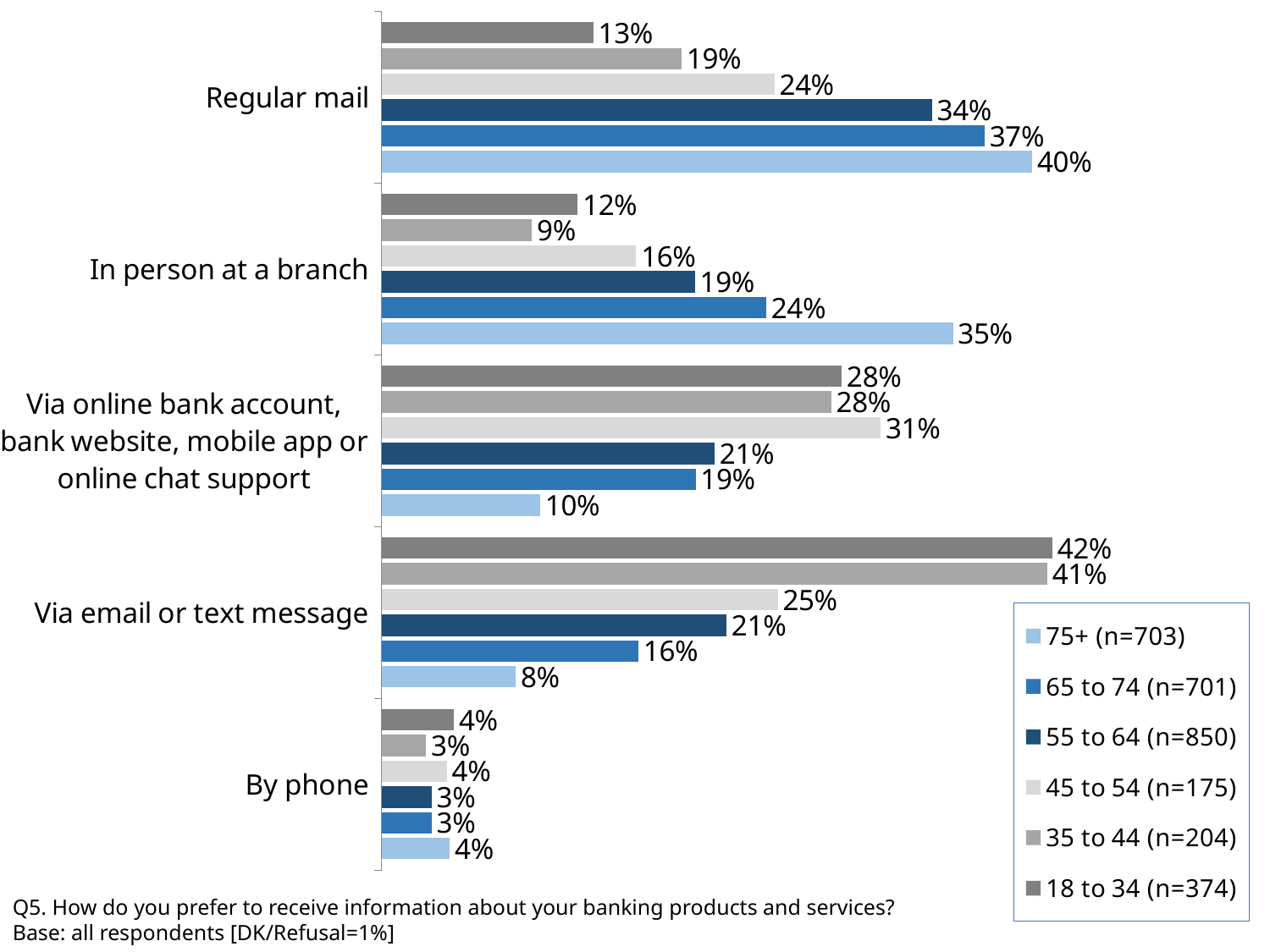
How many series does the legend list? 6 What is the difference between the 75+ (n=703) and 18 to 34 (n=374) values for Regular mail? 27% Which age group has the lowest value for Via email or text message? 75+ (n=703) What is the value for the 18 to 34 (n=374) group for Via email or text message? 42% For Via online bank account, bank website, mobile app or online chat support, which is larger: the value for 45 to 54 (n=175) or the value for 55 to 64 (n=850)? 45 to 54 (n=175) What is the value for the 75+ (n=703) group for Regular mail? 40% How many categories are shown on the chart? 5 Which age group has the lowest value for Regular mail? 18 to 34 (n=374) Which age group has the highest value for In person at a branch? 75+ (n=703) What is the value for the 35 to 44 (n=204) group for By phone? 3% What kind of chart is shown on the slide? Bar chart What is the value for the 65 to 74 (n=701) group for In person at a branch? 24%